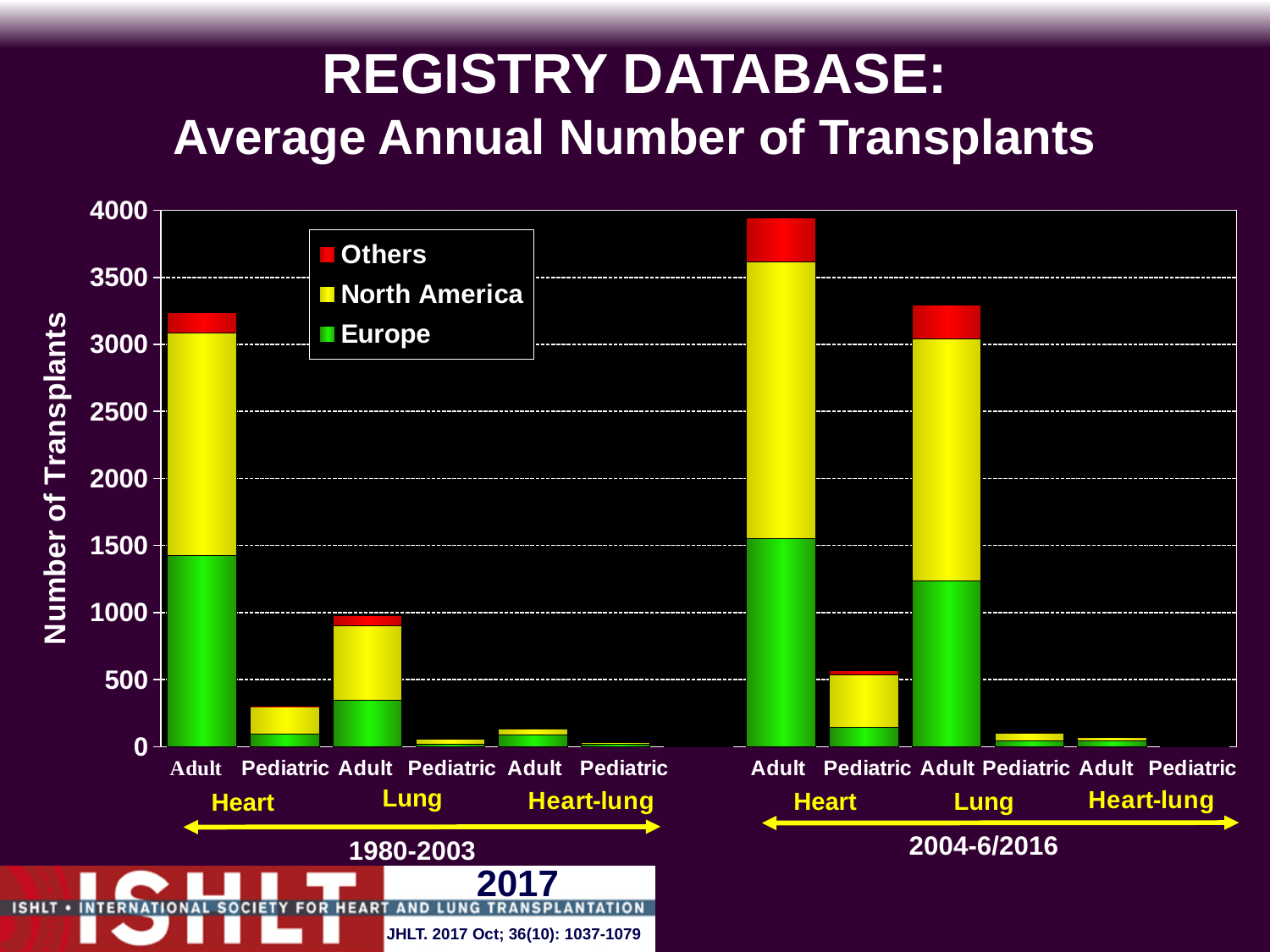
What kind of chart is shown on the slide? Stacked bar chart How many bars are plotted on the chart in total? 12 What colour represents Europe in the legend? Green Is the total value for Adult Heart transplants in 2004-6/2016 greater or less than 3500? greater What is the title of the y axis? Number of Transplants Is the total value for Adult Lung transplants in 1980-2003 greater or less than 1500? less Is the total value for Adult Lung transplants in 2004-6/2016 greater or less than 3000? greater Which is larger: Adult Lung transplants in 1980-2003 or Adult Lung transplants in 2004-6/2016? 2004-6/2016 Which bar is the highest on the chart? Adult Heart, 2004-6/2016 How many series does the legend list? 3 Which is larger: Pediatric Heart transplants in 1980-2003 or Pediatric Heart transplants in 2004-6/2016? 2004-6/2016